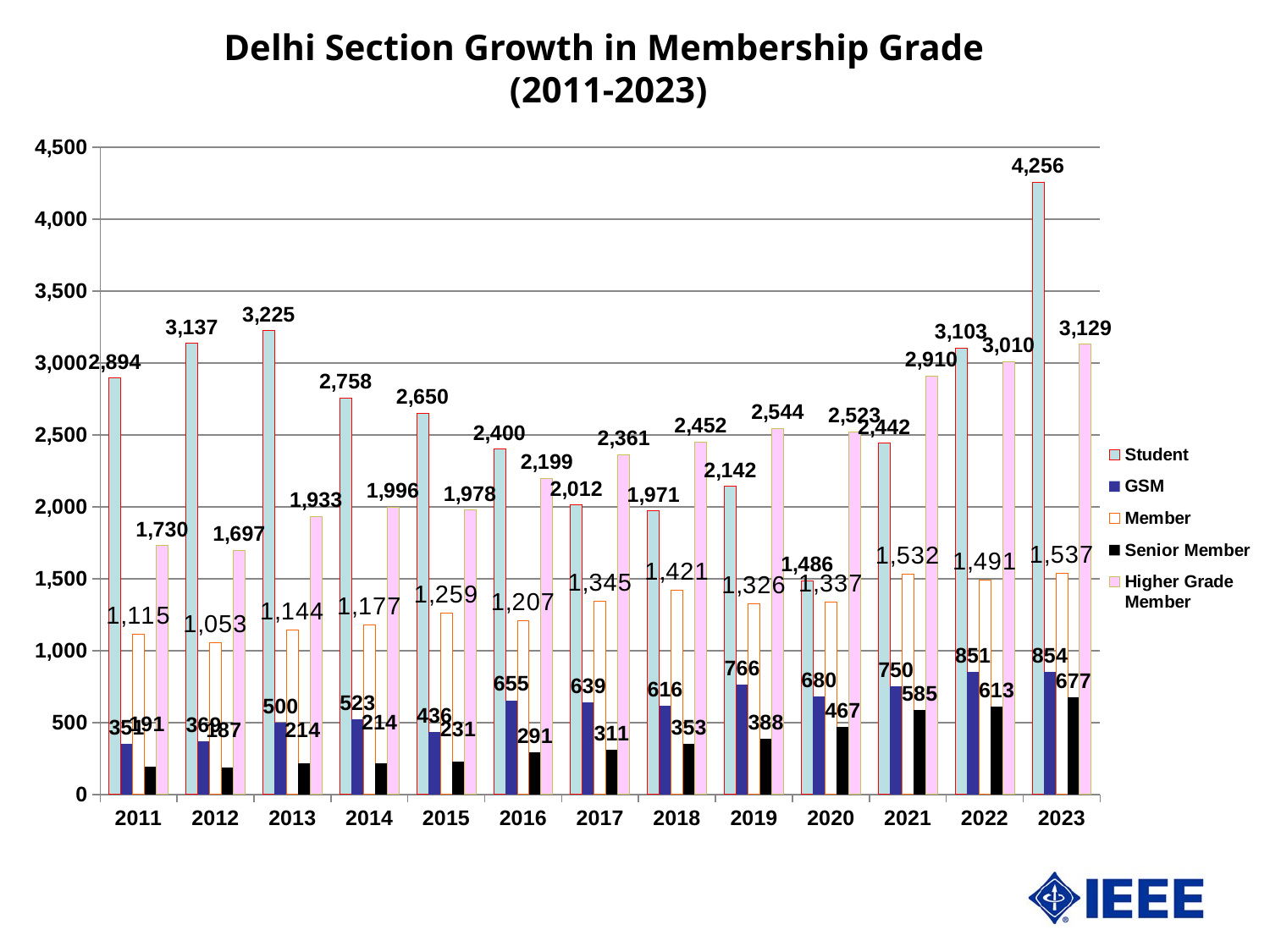
What is the Student value for 2023? 4,256 What kind of chart is shown on the slide? bar chart Does the Senior Member value generally rise or fall from 2011 to 2023? rise How many series does the legend list? 5 What is the Higher Grade Member value for 2016? 2,199 What is the Senior Member value for 2019? 388 In which year is the Senior Member value lowest? 2012 Is the GSM value for 2011 greater or less than 500? less Which is larger in 2021, the Higher Grade Member value or the Student value? Higher Grade Member What is the difference between the Student values for 2023 and 2022? 1,153 In which year is the Student value highest? 2023 How many years are shown on the x axis? 13